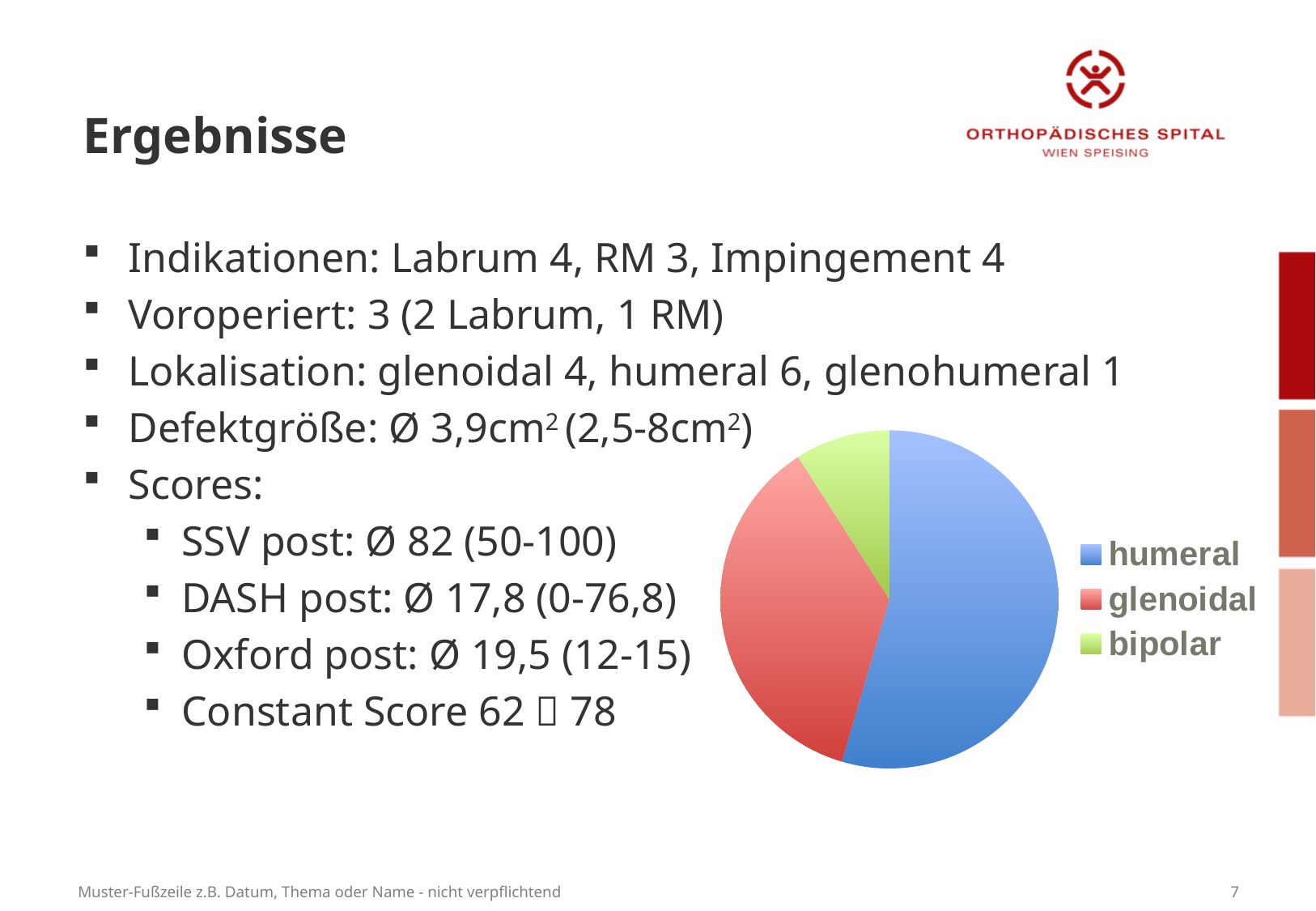
Which slice is larger in the pie chart, glenoidal or bipolar? glenoidal How many entries does the legend of the pie chart list? 3 How many slices does the pie chart have? 3 Which category has the smallest slice in the pie chart? bipolar Which colour represents the humeral slice in the pie chart? blue Which category is shown in green in the pie chart? bipolar What kind of chart is shown on the slide? pie chart Which category has the largest slice in the pie chart? humeral Which slice is larger in the pie chart, humeral or glenoidal? humeral